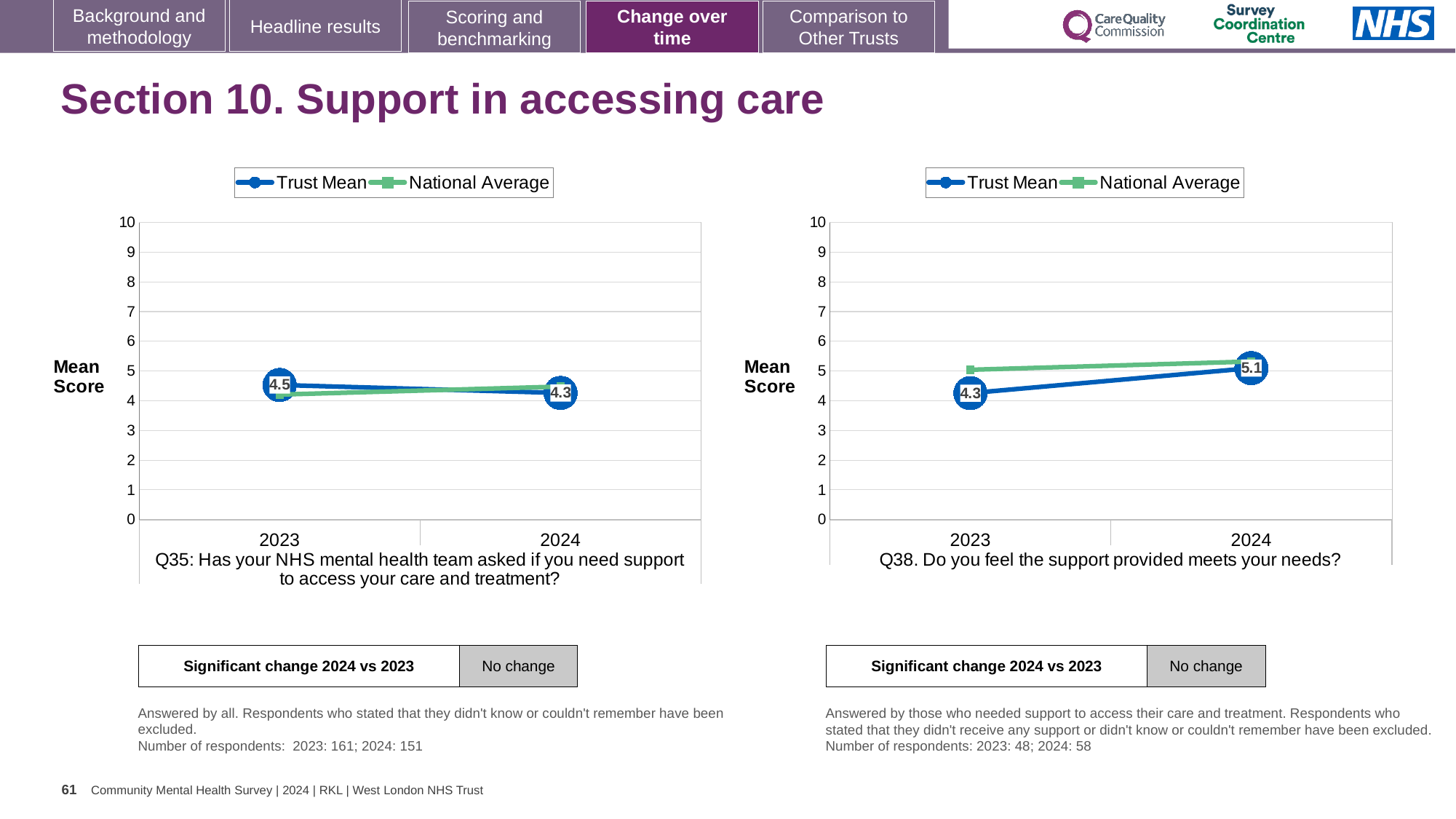
In the Q35 chart (left), does the Trust Mean rise or fall from 2023 to 2024? fall In the Q35 chart (left), what is the difference between the Trust Mean in 2023 and 2024? 0.2 In the Q38 chart (right), what is the Trust Mean score for 2024? 5.1 In the Q38 chart (right), which is larger in 2024: the Trust Mean or the National Average? National Average What type of chart is used for Q38 (right)? line chart In the Q35 chart (left), what is the Trust Mean score for 2023? 4.5 In the Q38 chart (right), what is the Trust Mean score for 2023? 4.3 How many series does the legend of the Q35 chart (left) list? 2 In the Q38 chart (right), is the National Average for 2023 greater or less than 4? greater In the Q38 chart (right), by how much did the Trust Mean change from 2023 to 2024? 0.8 In the Q38 chart (right), does the Trust Mean rise or fall from 2023 to 2024? rise In the Q35 chart (left), what is the Trust Mean score for 2024? 4.3